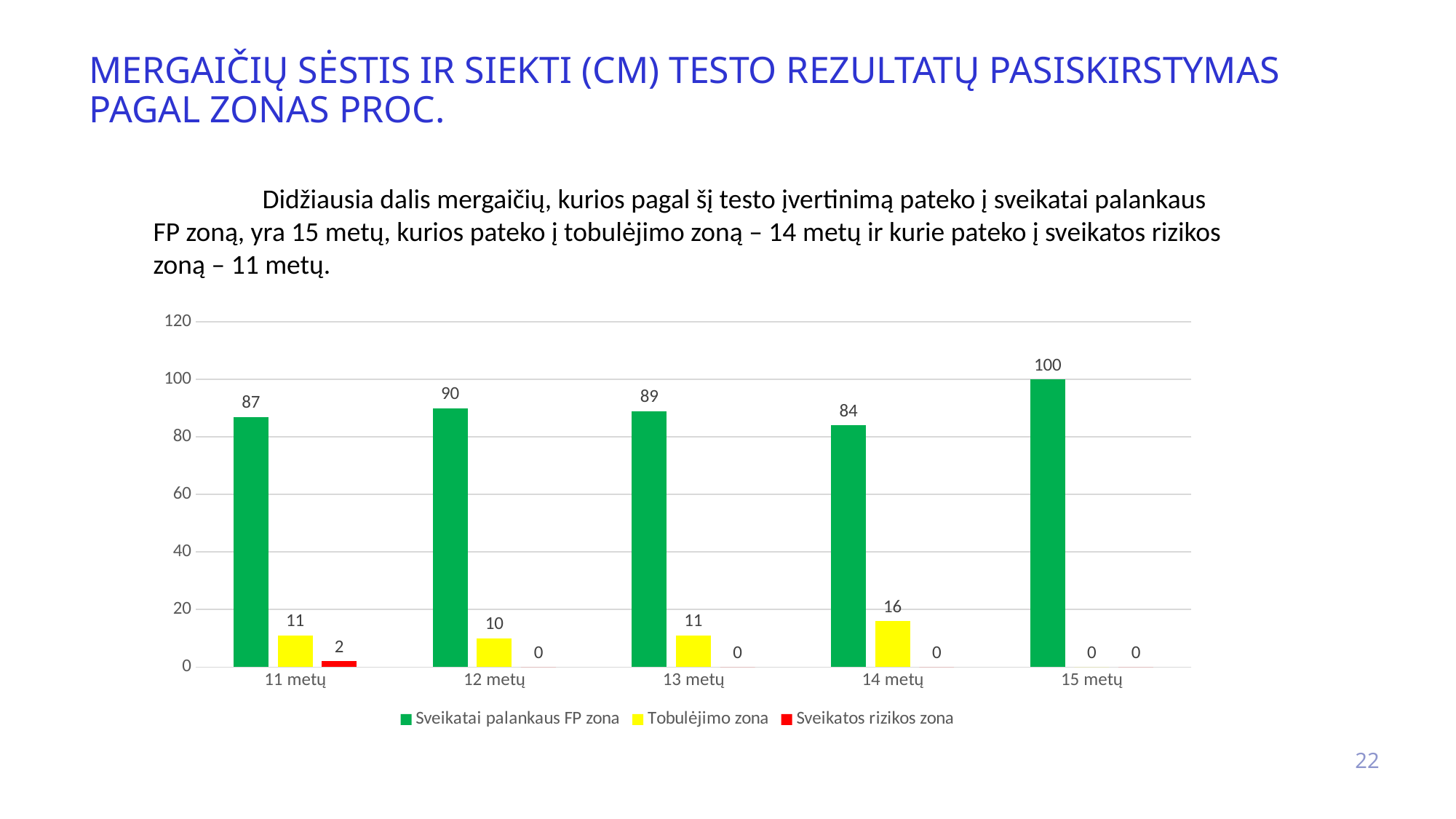
What is the value for Sveikatos rizikos zona at 11 metų? 2 Is the value for Sveikatai palankaus FP zona at 12 metų greater or less than 80? greater What is the value for Tobulėjimo zona at 14 metų? 16 What colour represents Sveikatos rizikos zona in the legend? Red Which age group has the highest value for Sveikatai palankaus FP zona? 15 metų What is the difference between the Sveikatai palankaus FP zona values at 15 metų and 14 metų? 16 What kind of chart is shown on the slide? Bar chart What is the value for Sveikatai palankaus FP zona at 11 metų? 87 How many series does the legend list? 3 Which age group has the lowest value for Sveikatai palankaus FP zona? 14 metų Which is larger: the Tobulėjimo zona value at 12 metų or at 14 metų? 14 metų How many age groups are shown on the x axis? 5